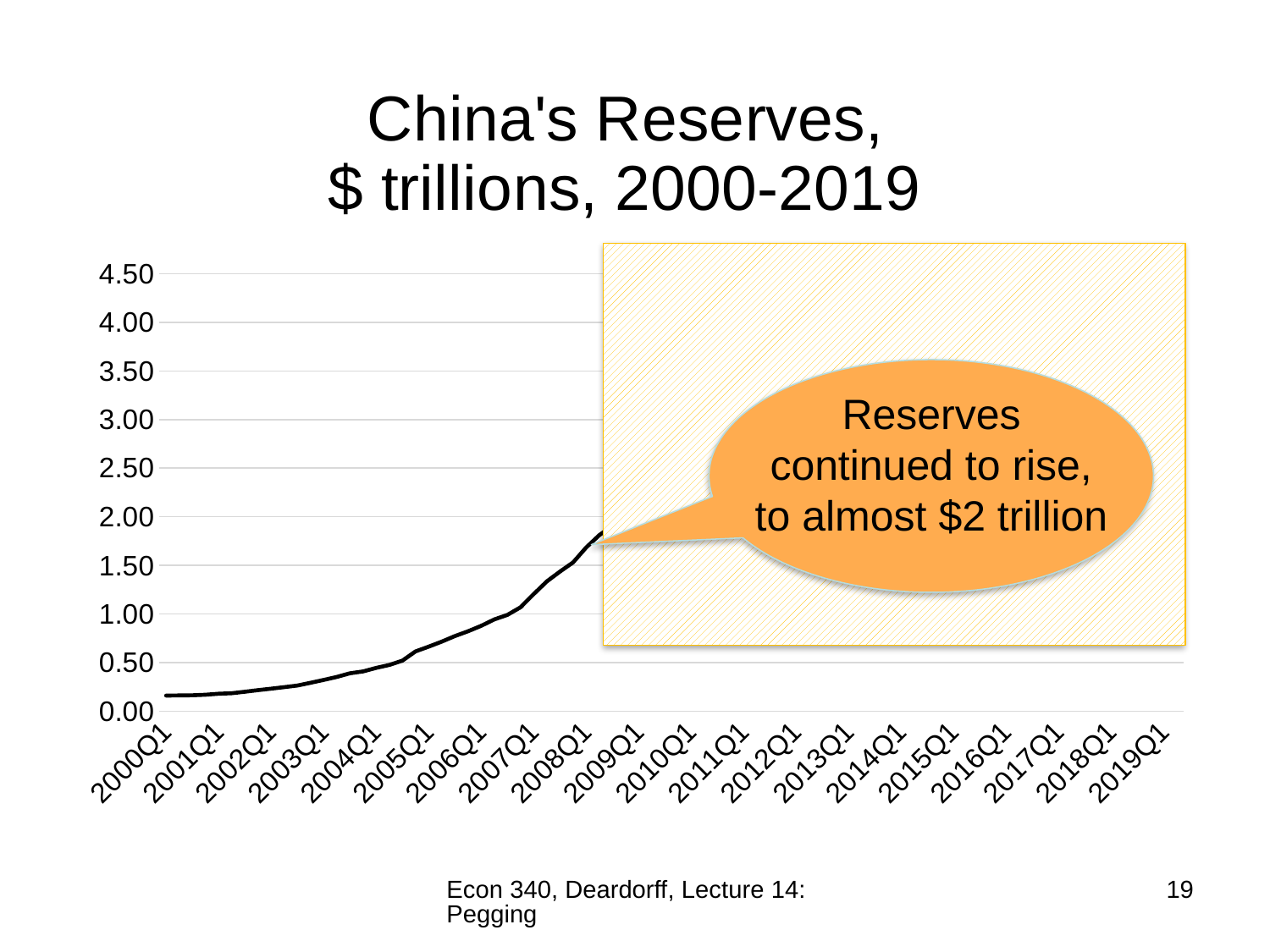
Is the value for 2000Q1 greater or less than 0.50? less What kind of chart is shown on the slide? line chart Is the value for 2008Q1 greater or less than 1.00? greater How many year labels are shown on the x axis? 20 Is the value for 2008Q1 greater or less than 2.00? less What is the highest tick value shown on the y axis? 4.50 Which has the larger value, 2004Q1 or 2008Q1? 2008Q1 Which x-axis label has the lowest visible value on the line? 2000Q1 What is the title of the chart? China's Reserves, $ trillions, 2000-2019 Does the visible line rise or fall from 2000Q1 to 2008Q1? rise